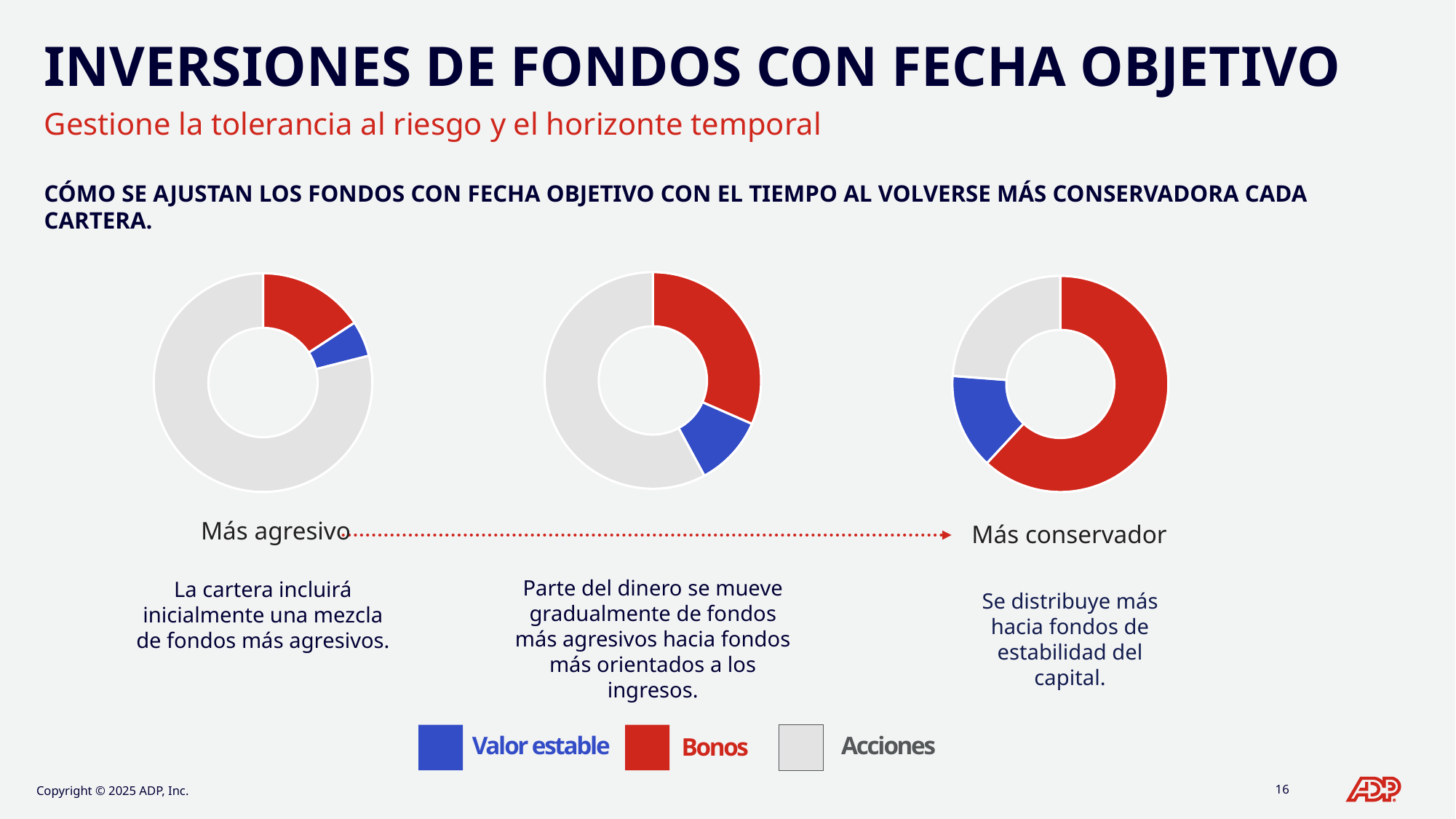
In the left donut chart (Más agresivo), which category has the largest share? Acciones In the middle donut chart, which category has the largest share? Acciones In the left donut chart (Más agresivo), which category has the smallest share? Valor estable In the right donut chart (Más conservador), which category has the smallest share? Valor estable In the right donut chart (Más conservador), which category has the largest share? Bonos In the right donut chart (Más conservador), which is larger: the share of Bonos or the share of Acciones? Bonos How many slices does the middle donut chart have? 3 What label appears under the left donut chart? Más agresivo What kind of chart is the left chart on the slide? Donut (pie) chart In the middle donut chart, which category has the smallest share? Valor estable Which colour represents Bonos in the legend? Red How many categories does the legend list? 3